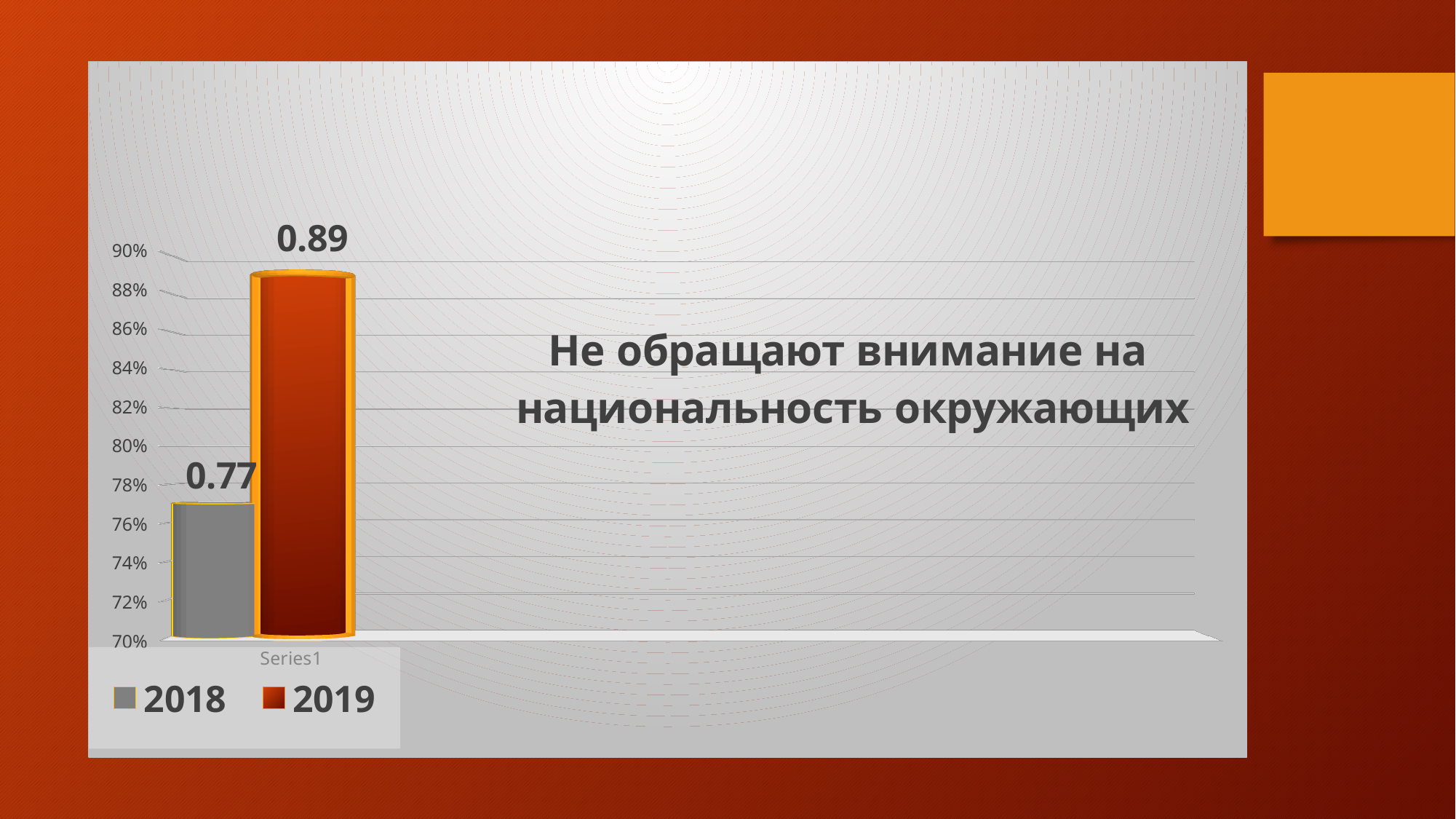
Which series has the highest value? 2019 Is the value for 2018 greater or less than 80%? less Is the value for 2019 greater or less than 86%? greater Which series has the higher value, 2018 or 2019? 2019 What kind of chart is shown on the slide? Bar chart How many series does the legend list? 2 What value is shown for the 2018 series? 0.77 Which series has the lowest value? 2018 What is the category label shown on the x axis? Series1 What value is shown for the 2019 series? 0.89 What is the difference between the 2019 value and the 2018 value? 0.12 What colour is the bar for the 2019 series? Red